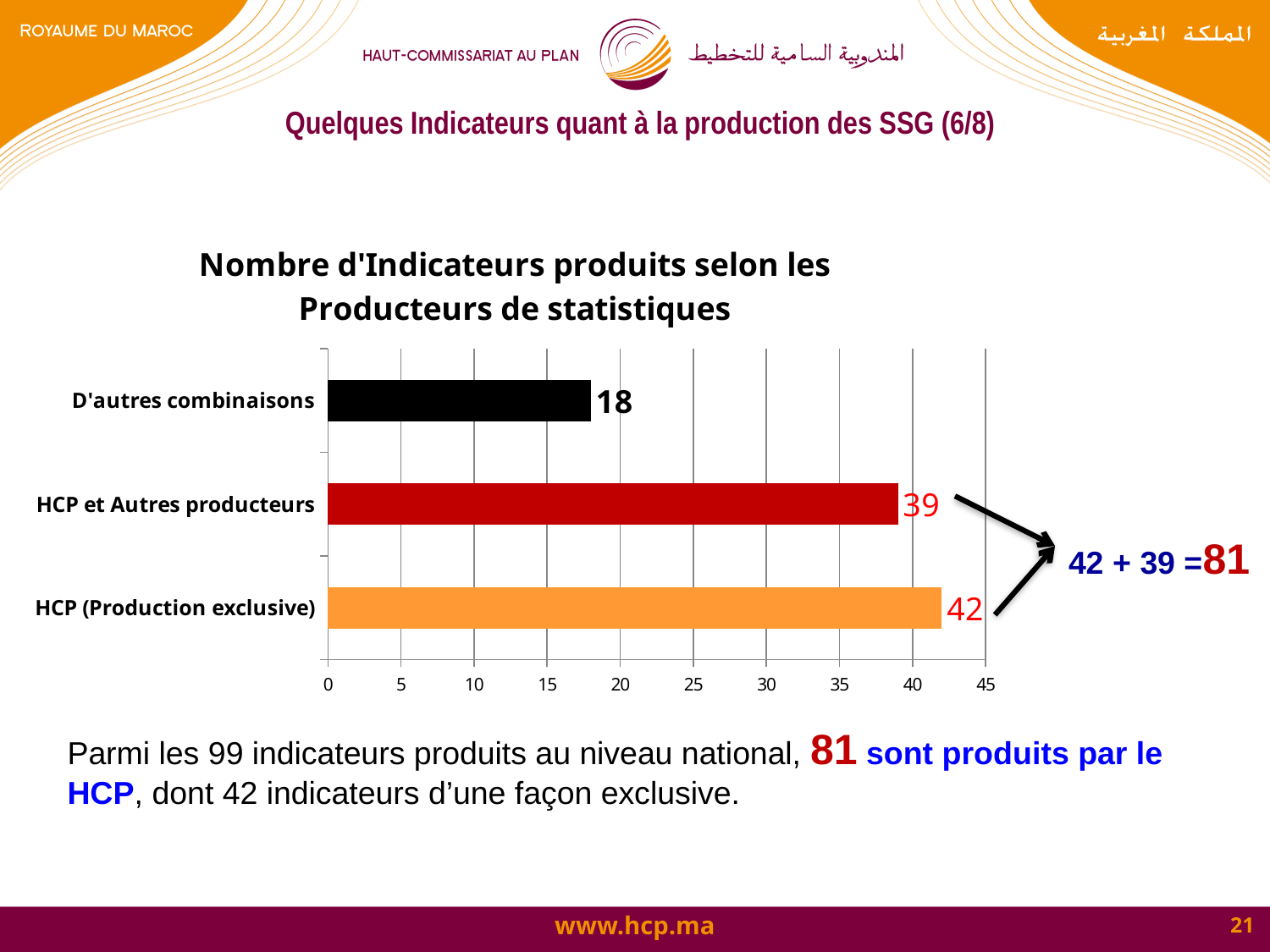
Is the value for D'autres combinaisons greater or less than 20? less What is the value for HCP (Production exclusive)? 42 Which category has the lowest value? D'autres combinaisons What is the title of the chart? Nombre d'Indicateurs produits selon les Producteurs de statistiques How many categories are shown in the chart? 3 What is the value for HCP et Autres producteurs? 39 What kind of chart is shown on the slide? bar chart What is the difference between the values for HCP (Production exclusive) and HCP et Autres producteurs? 3 What is the difference between the values for HCP et Autres producteurs and D'autres combinaisons? 21 Which category has the highest value? HCP (Production exclusive) Which is larger, the value for HCP et Autres producteurs or the value for D'autres combinaisons? HCP et Autres producteurs What is the value for D'autres combinaisons? 18